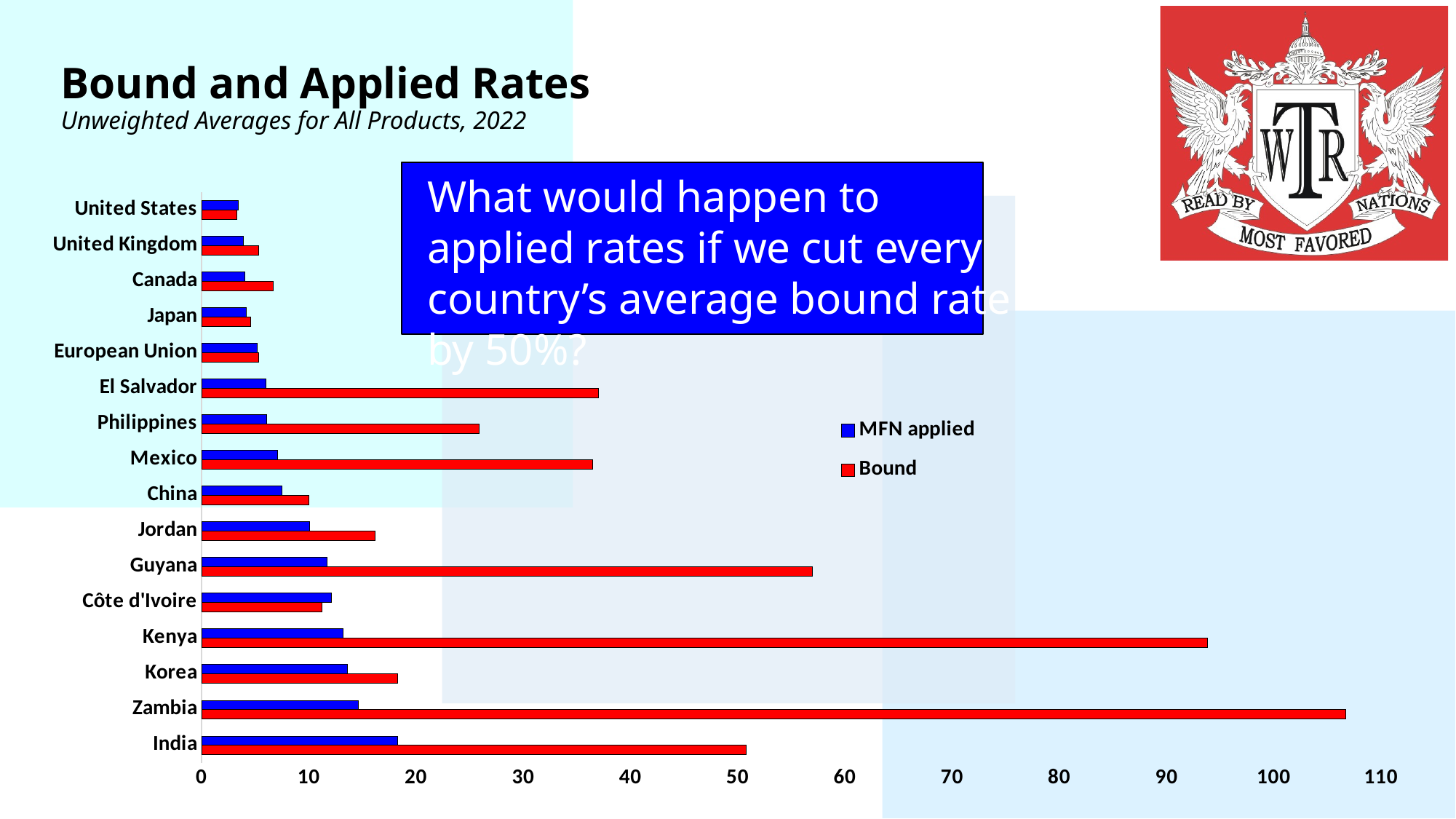
Is the Bound value for Zambia greater or less than 100? greater What is the title of the chart? Bound and Applied Rates Is the Bound value for Kenya greater or less than 90? greater Which country has the highest MFN applied rate? India How many countries are plotted on the chart? 16 Which is larger, the Bound rate for Kenya or the Bound rate for Guyana? Kenya Which country has the highest Bound rate? Zambia Which colour represents the Bound series in the legend? Red What kind of chart is shown on the slide? Bar chart How many series does the legend list? 2 Is the MFN applied value for India greater or less than 20? less